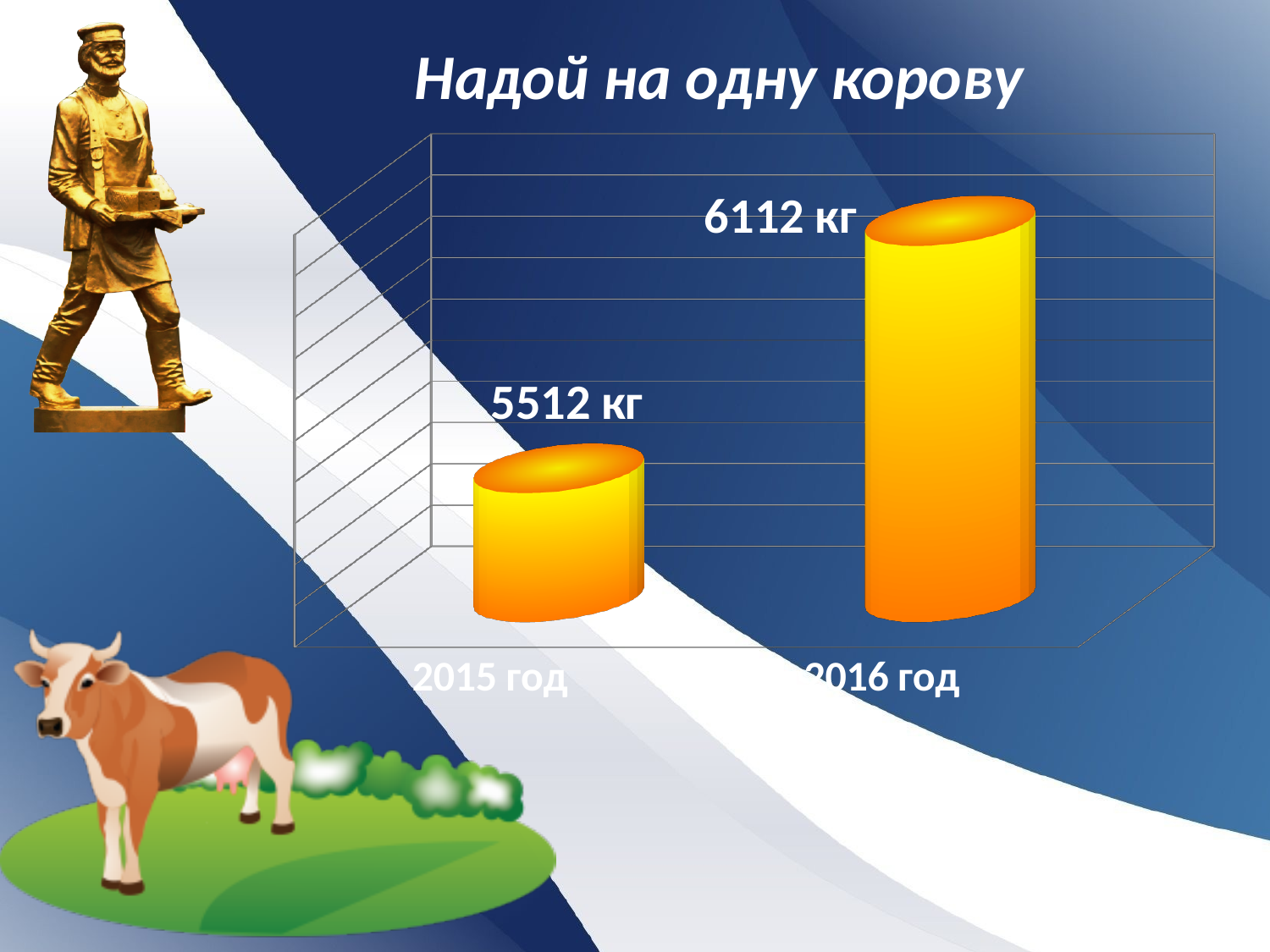
What is the value for 2015 год? 5512 кг How many categories are shown in the chart? 2 What is the title of the chart? Надой на одну корову What colour are the bars in the chart? Orange/yellow Do the values rise or fall from 2015 год to 2016 год? Rise What is the value for 2016 год? 6112 кг Which year has the lowest value? 2015 год What is the difference between the values for 2016 год and 2015 год? 600 кг Which year has the highest value? 2016 год What kind of chart is shown on the slide? Bar chart Which is larger, the value for 2015 год or for 2016 год? 2016 год